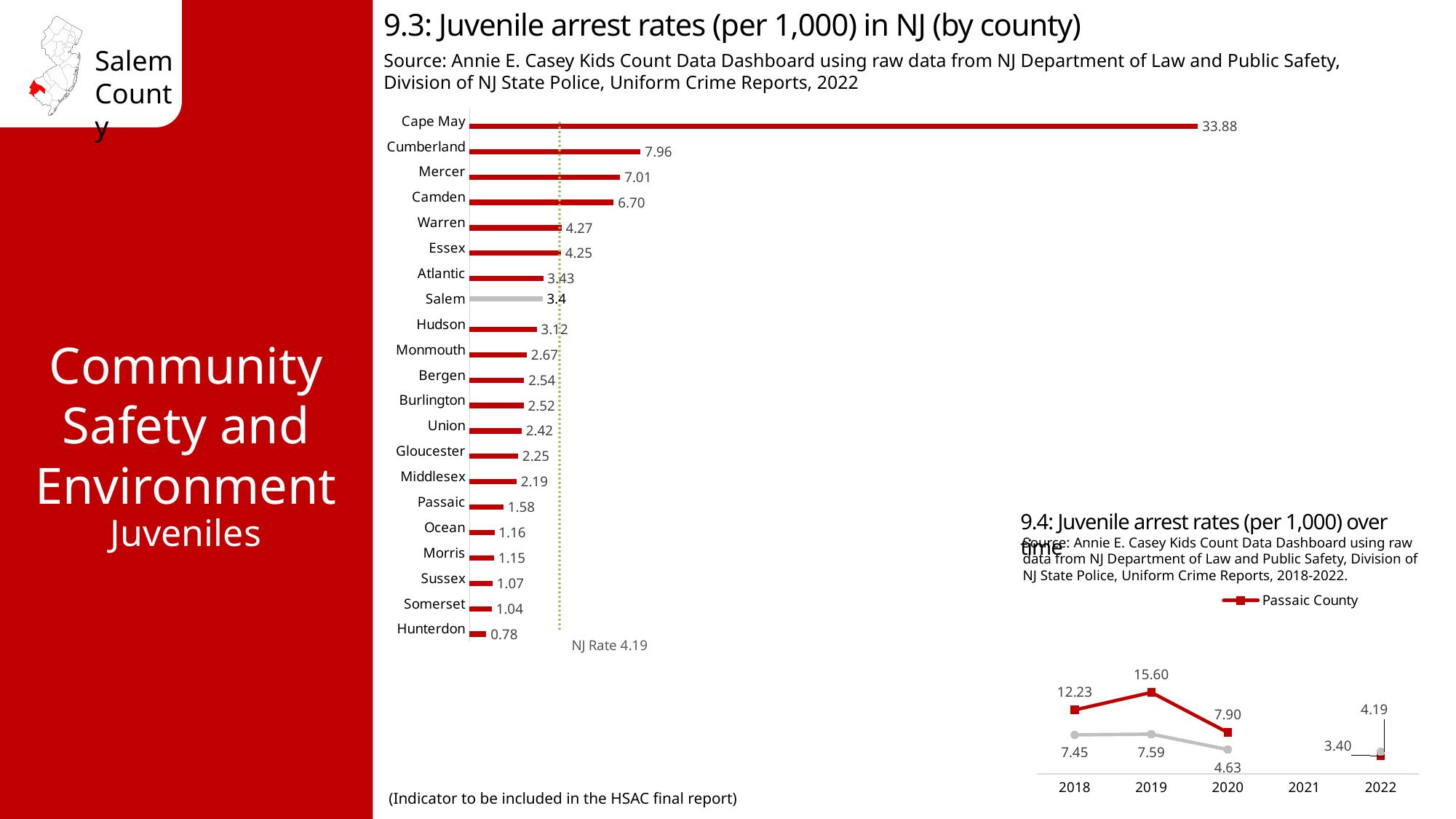
In the chart '9.3: Juvenile arrest rates (per 1,000) in NJ (by county)', what is the value for Salem? 3.4 In the chart '9.3: Juvenile arrest rates (per 1,000) in NJ (by county)', what NJ rate is marked by the dotted line? 4.19 In the chart '9.3: Juvenile arrest rates (per 1,000) in NJ (by county)', which county has the lowest juvenile arrest rate? Hunterdon In the chart '9.3: Juvenile arrest rates (per 1,000) in NJ (by county)', how many counties are shown? 21 In the chart '9.4: Juvenile arrest rates (per 1,000) over time', in which year does the Passaic County line reach its highest value? 2019 In the chart '9.4: Juvenile arrest rates (per 1,000) over time', what is the difference between the Passaic County values in 2018 and 2020? 4.33 In the chart '9.3: Juvenile arrest rates (per 1,000) in NJ (by county)', which county has the highest juvenile arrest rate? Cape May What kind of chart is '9.3: Juvenile arrest rates (per 1,000) in NJ (by county)'? Bar chart In the chart '9.3: Juvenile arrest rates (per 1,000) in NJ (by county)', which has a higher value, Warren or Hudson? Warren In the chart '9.3: Juvenile arrest rates (per 1,000) in NJ (by county)', what is the value for Cumberland? 7.96 In the chart '9.3: Juvenile arrest rates (per 1,000) in NJ (by county)', what is the difference between the values for Mercer and Camden? 0.31 In the chart '9.4: Juvenile arrest rates (per 1,000) over time', what is the value of the Passaic County line in 2019? 15.60